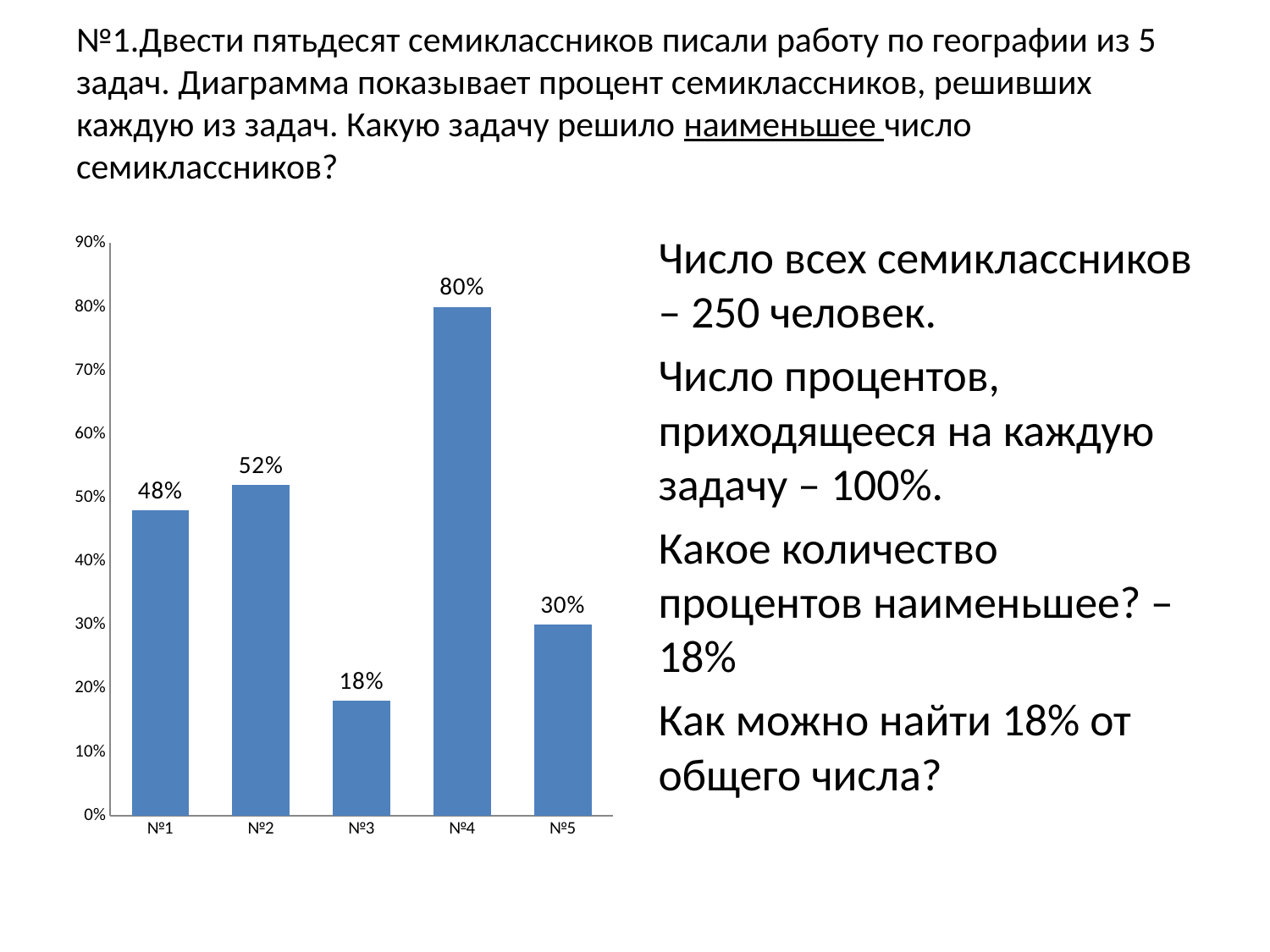
Is the value for №4 greater or less than 70%? greater How many categories are shown on the chart? 5 Which category has the lowest value? №3 What is the value for №5? 30% Which category has the highest value? №4 What is the difference between the values for №4 and №3? 62% Which is larger, the value for №2 or the value for №5? №2 What is the highest value shown on the vertical axis? 90% What kind of chart is shown on the slide? bar chart What is the value for №3? 18% What is the difference between the values for №2 and №1? 4% What is the value for №1? 48%